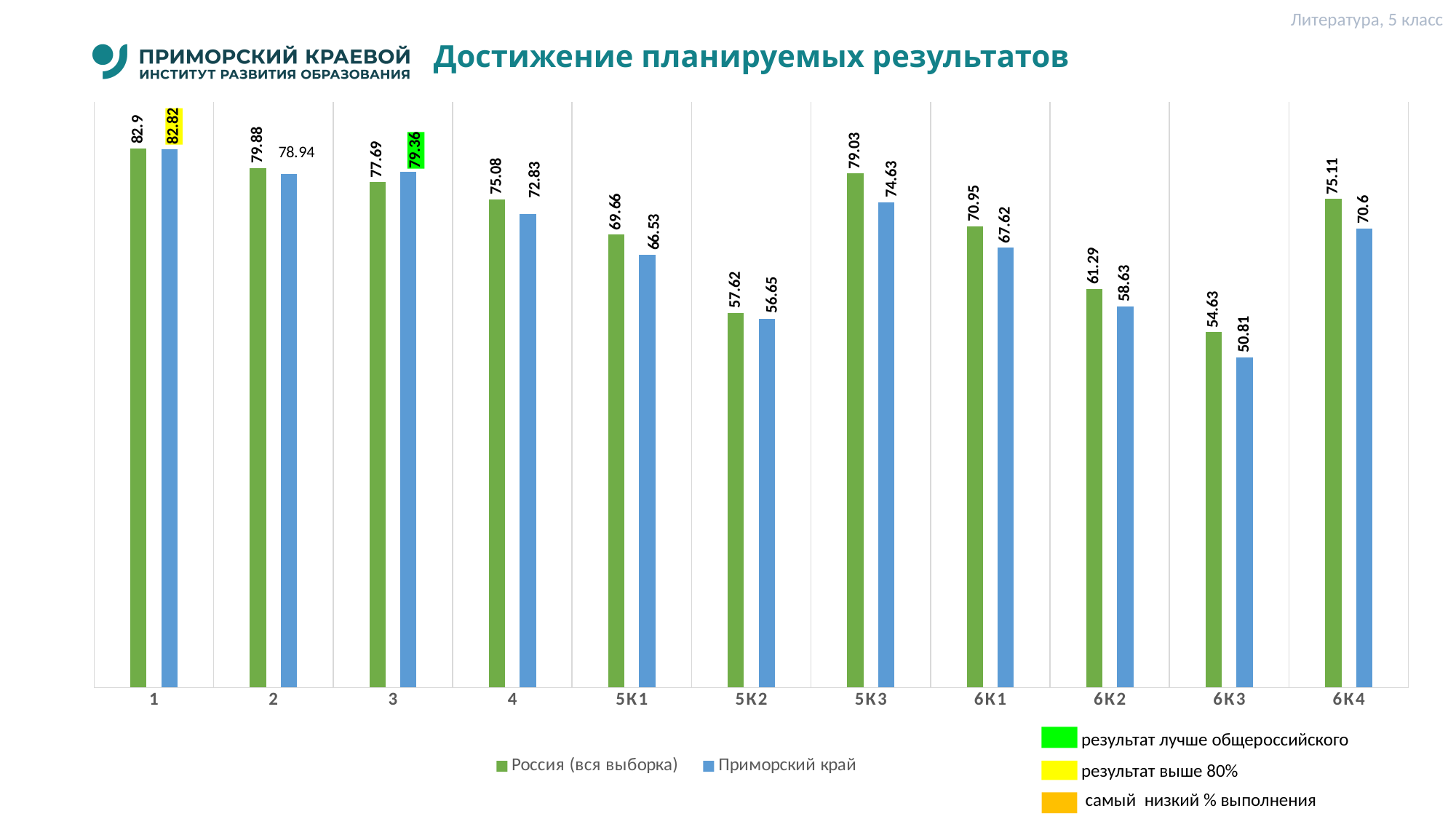
What is the difference between the Россия (вся выборка) and Приморский край values for category 6К4? 4.51 What is the title of the chart? Достижение планируемых результатов What is the value for Приморский край for category 3? 79.36 How many categories are shown on the x axis? 11 For category 3, which series has the larger value: Россия (вся выборка) or Приморский край? Приморский край How many series does the legend list? 2 What kind of chart is shown on the slide? bar chart What is the value for Россия (вся выборка) for category 5К3? 79.03 Which category has the lowest value for Россия (вся выборка)? 6К3 What is the value for Приморский край for category 6К3? 50.81 Which is larger: the Приморский край value for 5К3 or the Приморский край value for 6К1? 5К3 Which category has the highest value for Приморский край? 1